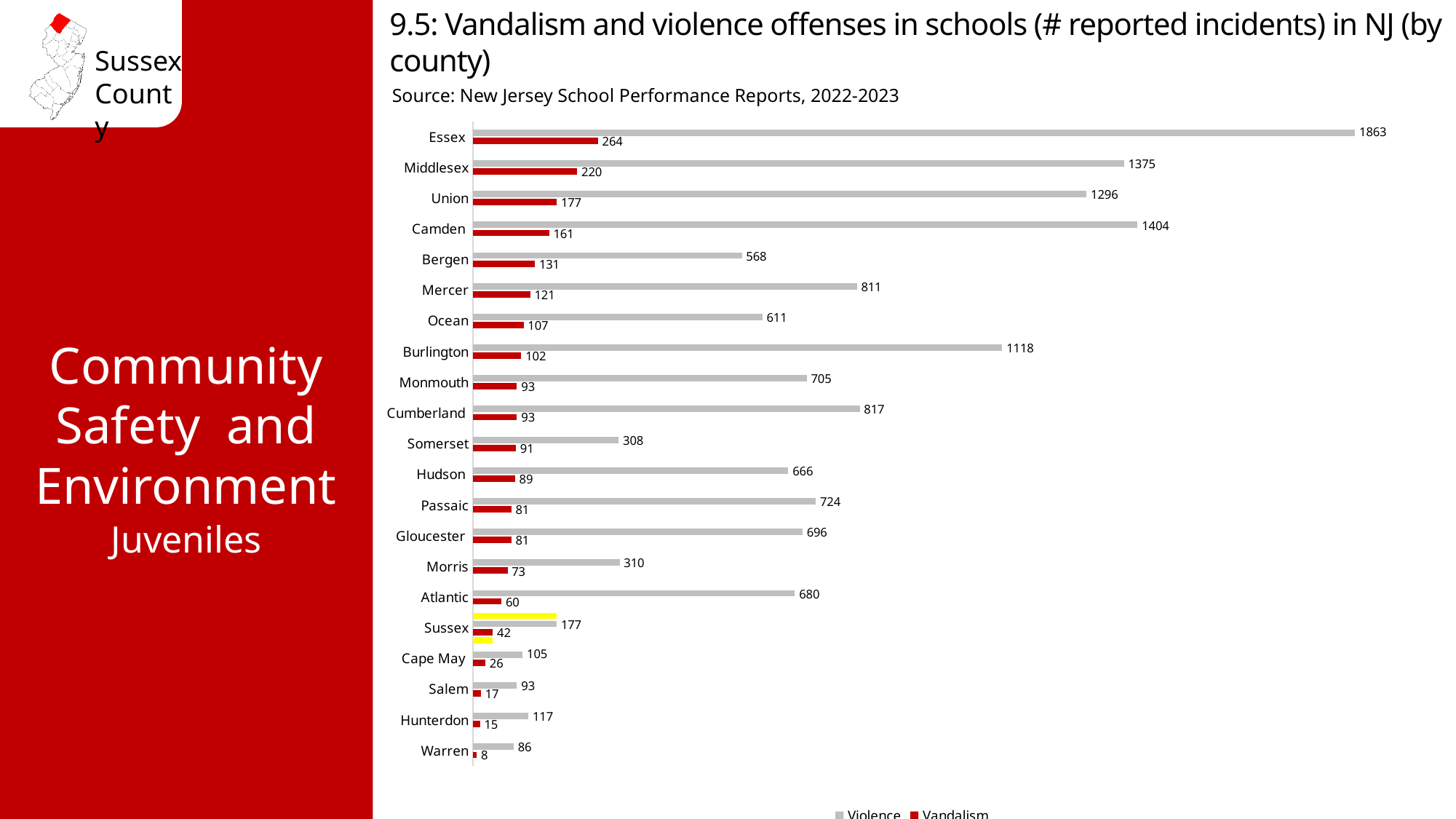
How many counties are shown in the chart? 21 What kind of chart is shown on the slide? Bar chart What is the difference between the violence incidents in Camden and Middlesex? 29 Which county has the lowest number of reported vandalism incidents? Warren What is the number of reported violence incidents in Essex County? 1863 Which county has the highest number of reported violence incidents? Essex What is the difference between violence and vandalism incidents in Sussex County? 135 Which county has more reported violence incidents, Mercer or Cumberland? Cumberland What is the number of reported violence incidents in Burlington County? 1118 Which series is shown in red in the chart? Vandalism How many series does the legend list? 2 What is the number of reported vandalism incidents in Sussex County? 42